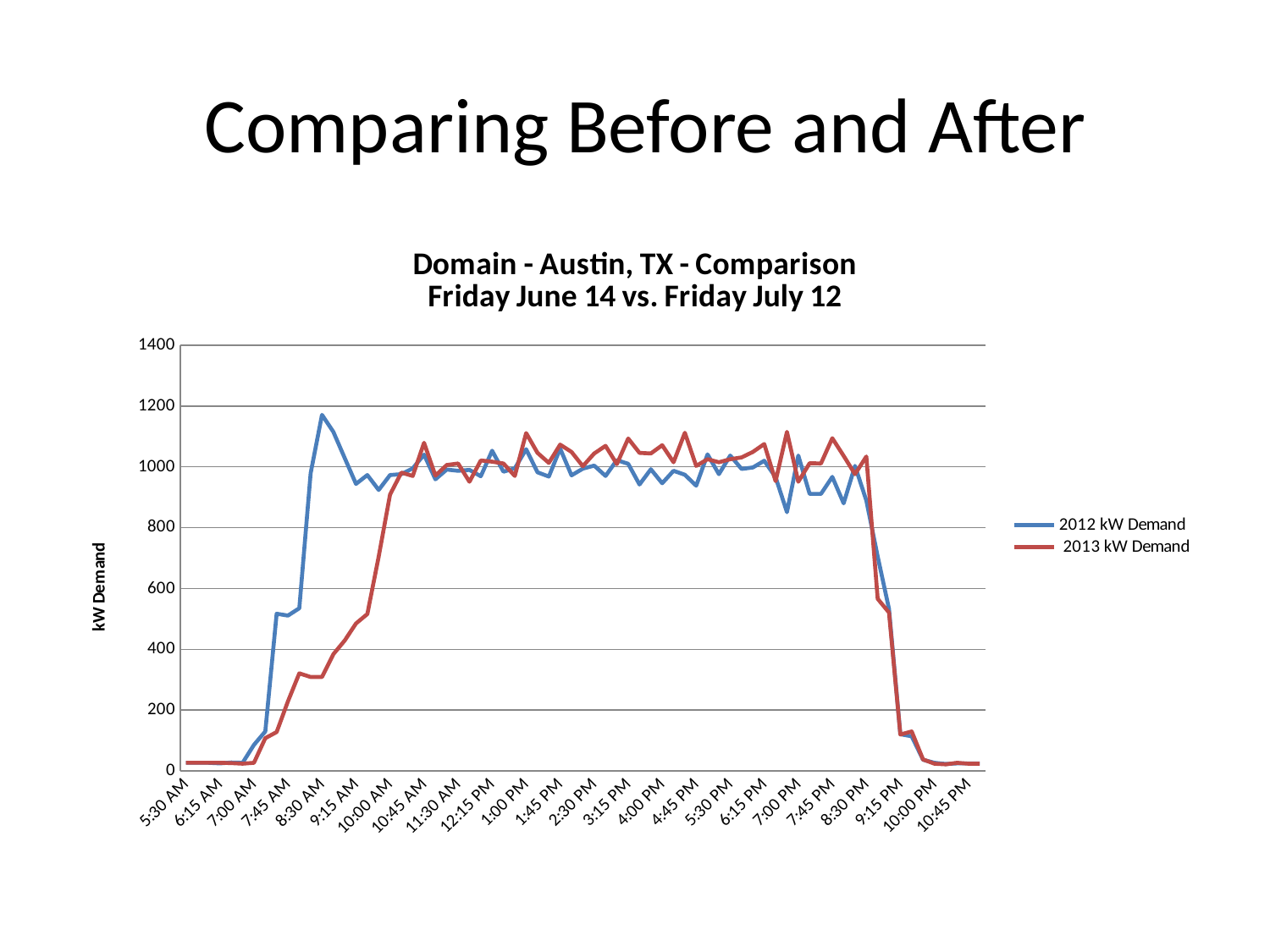
Is the 2013 kW Demand value at 7:45 AM greater or less than 200? greater How many series does the legend list? 2 What is the title of the chart? Domain - Austin, TX - Comparison Friday June 14 vs. Friday July 12 Is the 2013 kW Demand value at 8:30 AM greater or less than 400? less At 8:30 AM, which series has the higher value, 2012 kW Demand or 2013 kW Demand? 2012 kW Demand Is the 2012 kW Demand value at 8:30 AM greater or less than 1000? greater Does the 2013 kW Demand line rise or fall between 7:00 AM and 10:00 AM? Rise What kind of chart is shown on the slide? Line chart At 7:00 PM, which series has the higher value, 2012 kW Demand or 2013 kW Demand? 2012 kW Demand Does the 2012 kW Demand line rise or fall between 8:30 PM and 9:15 PM? Fall What is the label on the vertical axis? kW Demand